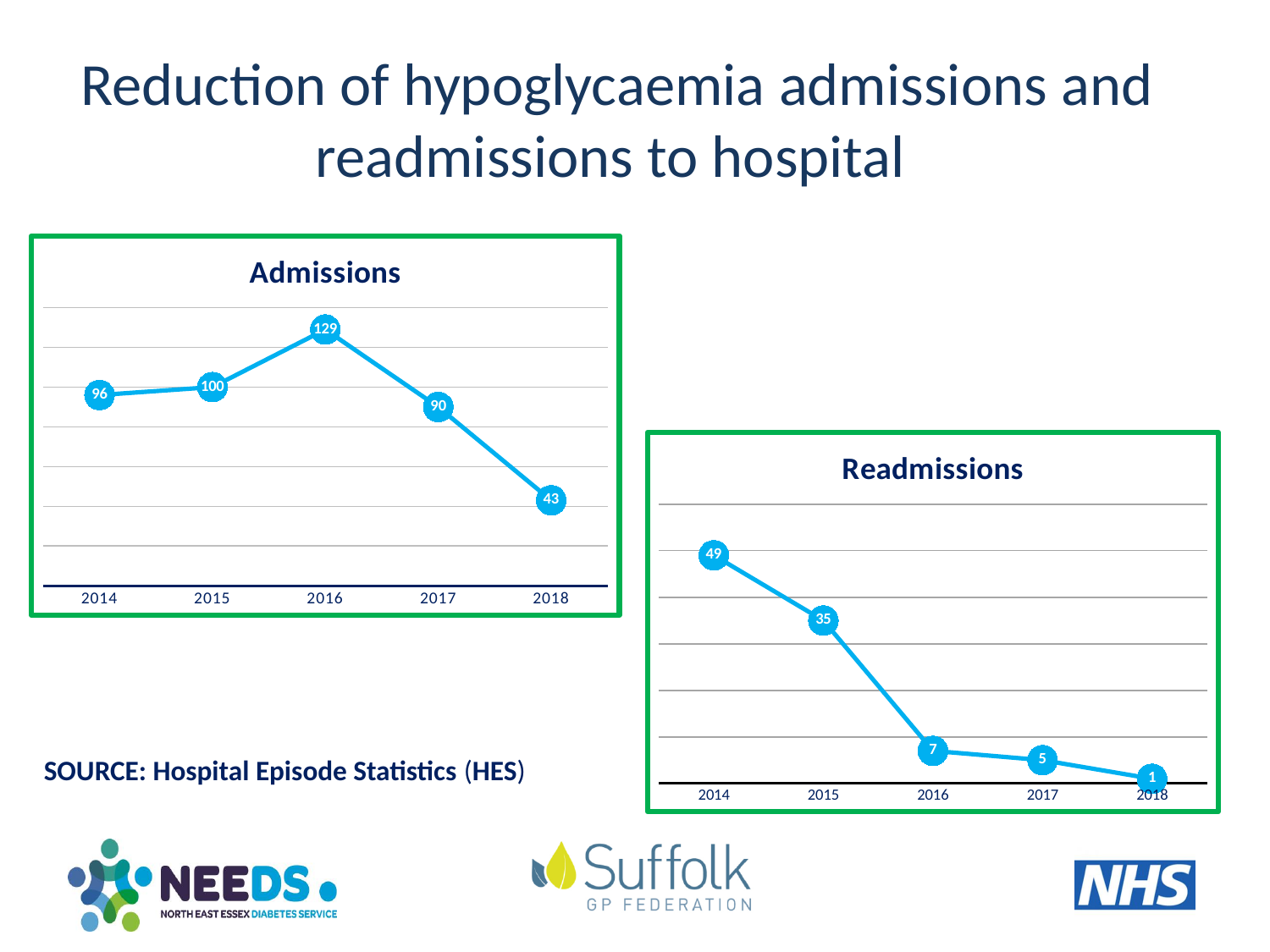
In the Readmissions chart, what is the value for 2018? 1 In the Admissions chart, which is larger, the value for 2015 or the value for 2017? 2015 How many years are plotted in the Readmissions chart? 5 In the Admissions chart, what is the value for 2016? 129 In the Readmissions chart, which year has the highest value? 2014 In the Readmissions chart, what is the value for 2014? 49 What kind of chart is the Readmissions chart? Line chart In the Admissions chart, what is the difference between the values for 2016 and 2018? 86 In the Readmissions chart, what is the difference between the values for 2014 and 2015? 14 In the Admissions chart, what is the value for 2018? 43 In the Admissions chart, which year has the highest value? 2016 In the Admissions chart, which year has the lowest value? 2018